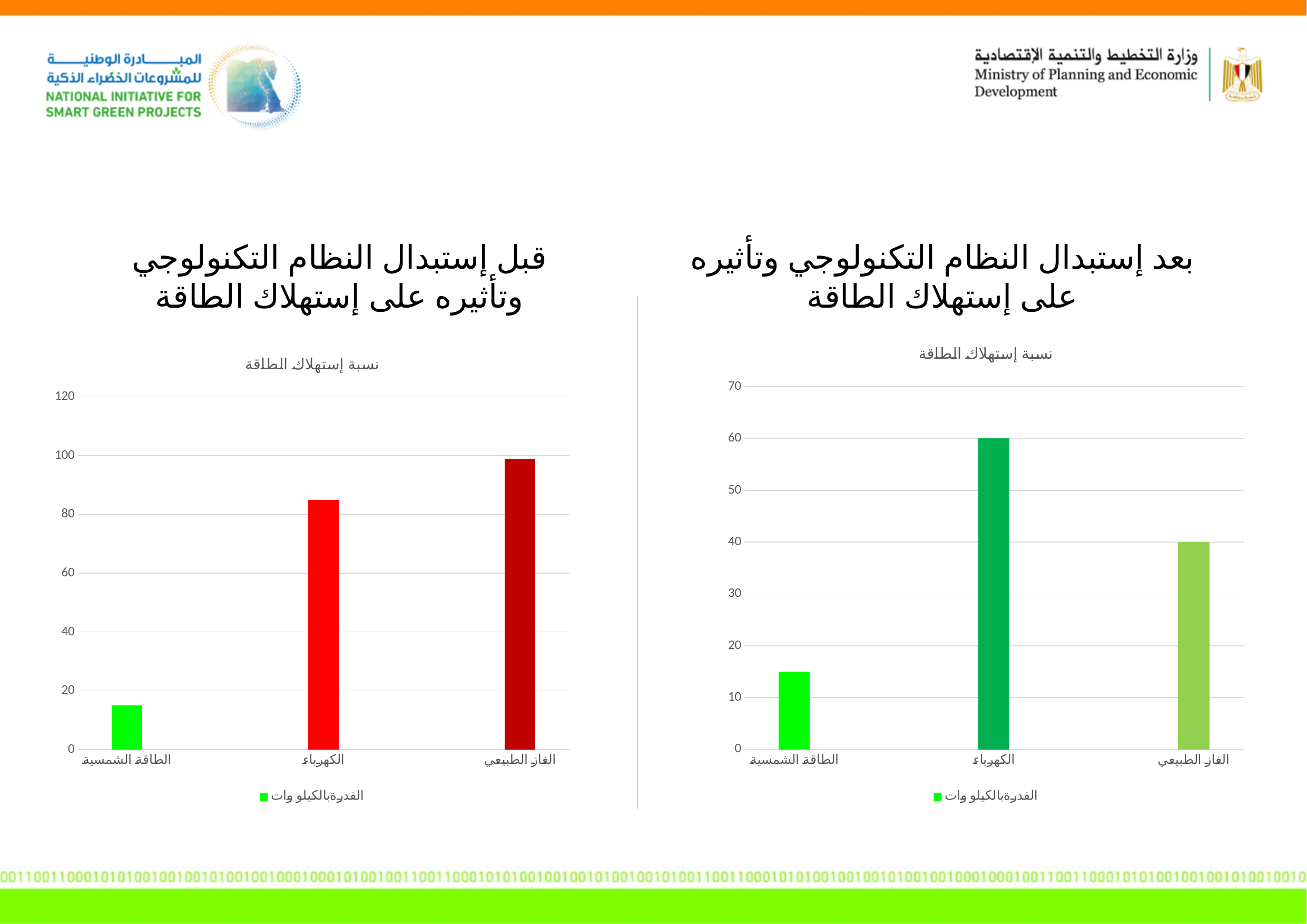
In the right chart (بعد إستبدال النظام التكنولوجي), is the value for الطاقة الشمسية greater or less than 20? less In the right chart (بعد إستبدال النظام التكنولوجي), what is the value for الكهرباء? 60 In the right chart (بعد إستبدال النظام التكنولوجي), what is the difference between the values for الكهرباء and الغاز الطبيعي? 20 What kind of chart is the right chart (بعد إستبدال النظام التكنولوجي)? bar chart How many categories are shown on the x axis of the left chart (قبل إستبدال النظام التكنولوجي)? 3 In the left chart (قبل إستبدال النظام التكنولوجي), is the value for الطاقة الشمسية greater or less than 20? less In the left chart (قبل إستبدال النظام التكنولوجي), which category has the highest value? الغاز الطبيعي In the left chart (قبل إستبدال النظام التكنولوجي), is the value for الغاز الطبيعي greater or less than 80? greater In the left chart (قبل إستبدال النظام التكنولوجي), which category has the lowest value? الطاقة الشمسية In the right chart (بعد إستبدال النظام التكنولوجي), what is the value for الغاز الطبيعي? 40 In the right chart (بعد إستبدال النظام التكنولوجي), which category has the lowest value? الطاقة الشمسية In the right chart (بعد إستبدال النظام التكنولوجي), which category has the highest value? الكهرباء